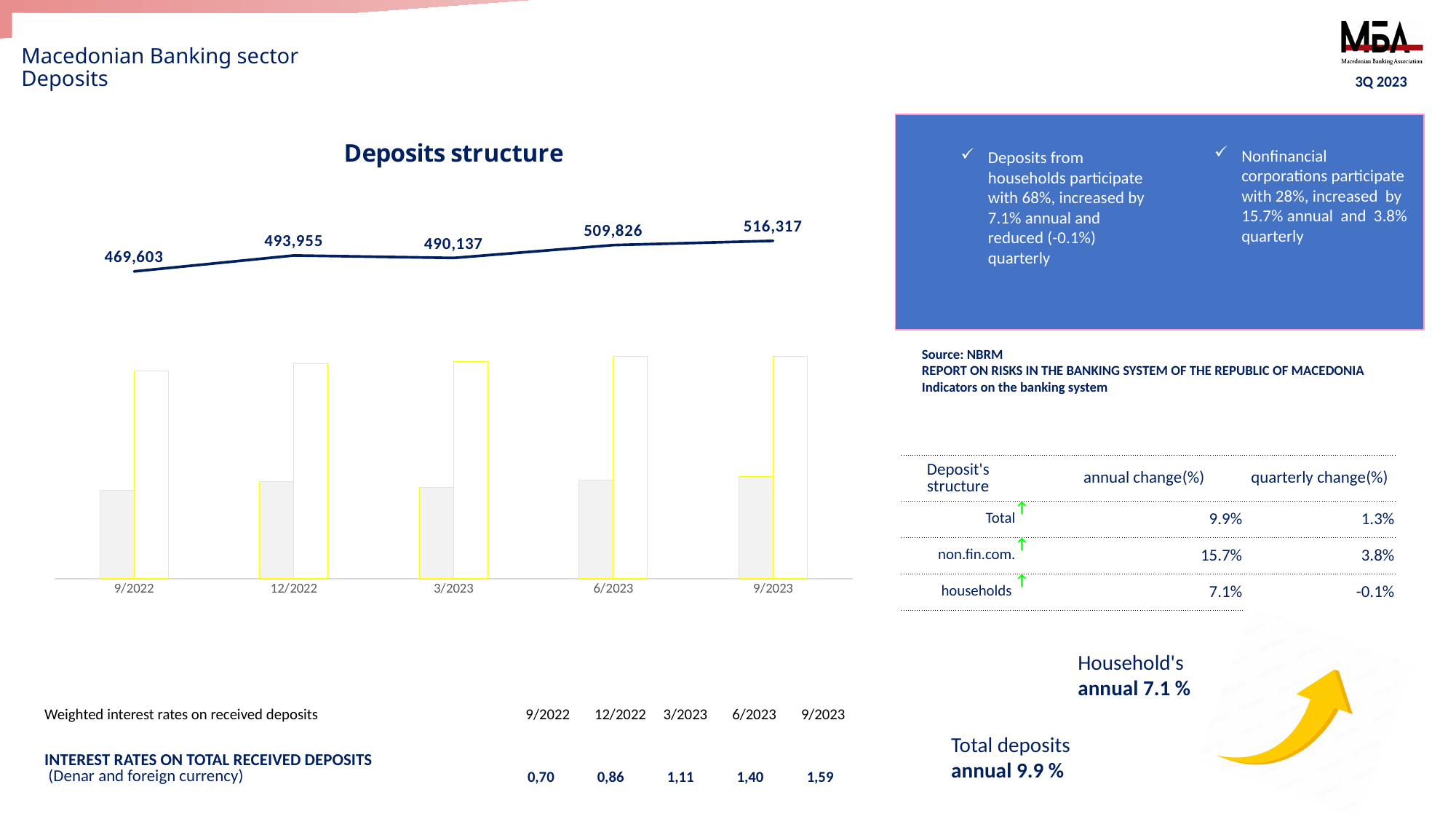
In the Deposits structure chart, which is larger: the line value at 12/2022 or at 3/2023? 12/2022 How many periods are shown on the x axis of the Deposits structure chart? 5 In the Deposits structure chart, at which period is the line value lowest? 9/2022 In the Deposits structure chart, what is the difference between the line values at 12/2022 and 3/2023? 3,818 In the Deposits structure chart, what is the value of the line at 9/2023? 516,317 In the Deposits structure chart, at which period is the line value highest? 9/2023 In the Deposits structure chart, what is the value of the line at 3/2023? 490,137 In the Deposits structure chart, what is the difference between the line values at 9/2023 and 9/2022? 46,714 In the Deposits structure chart, at 9/2023, which bar is taller: the grey bar or the yellow-outlined bar? the yellow-outlined bar In the Deposits structure chart, what is the value of the line at 9/2022? 469,603 What is the title of the chart on the left of the slide? Deposits structure In the Deposits structure chart, does the line value rise or fall from 9/2022 to 9/2023 overall? rise